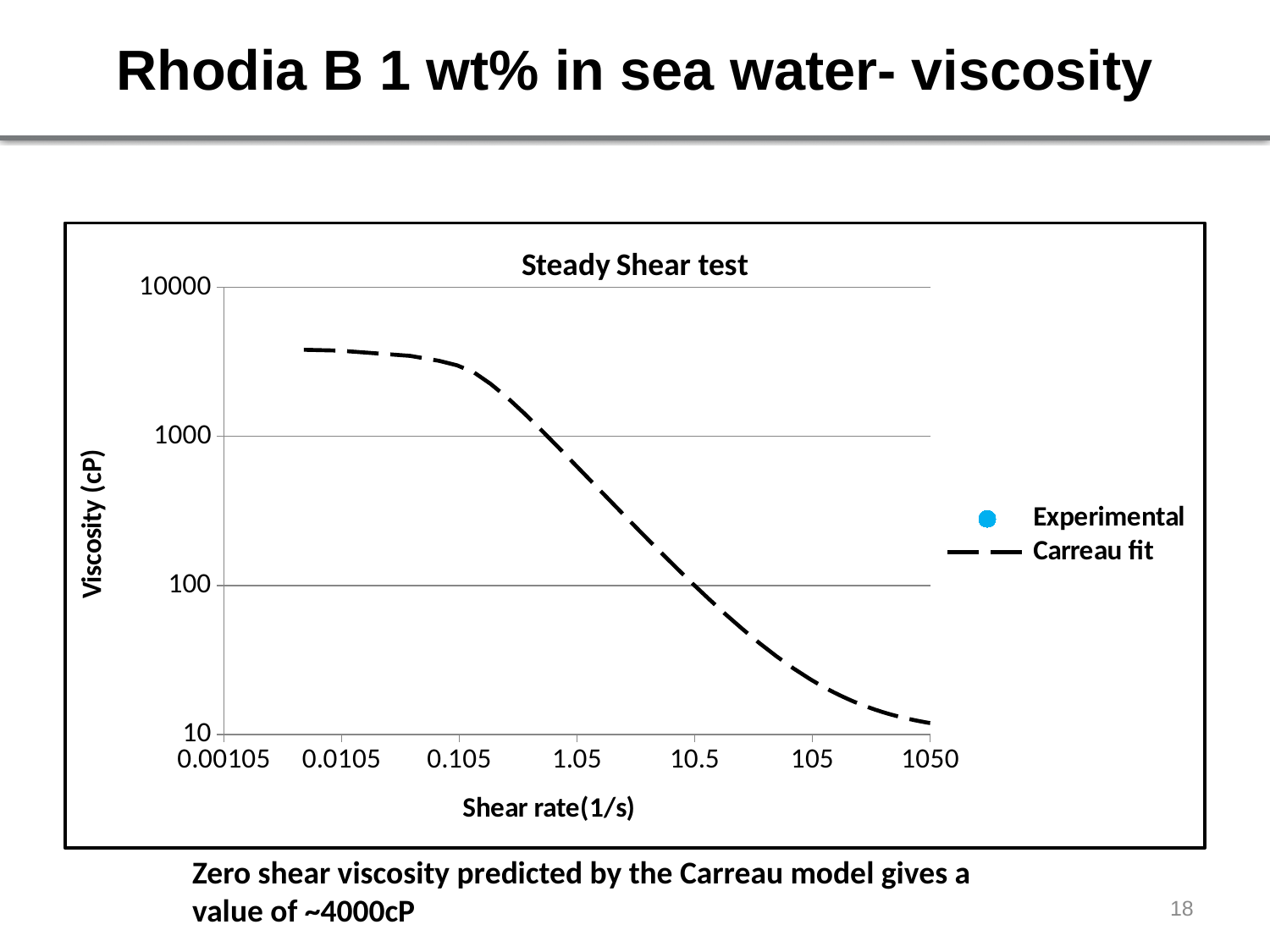
How many series does the chart legend list? 2 Is the Carreau fit viscosity at a shear rate of 0.0105 1/s greater or less than 1000 cP? greater Does the Carreau fit viscosity rise or fall as shear rate increases along the x axis? fall What is the label of the y axis? Viscosity (cP) What are the two series named in the legend? Experimental and Carreau fit What is the label of the x axis? Shear rate(1/s) Is the Carreau fit viscosity at a shear rate of 1.05 1/s greater or less than 1000 cP? less What kind of chart is shown on the slide? line chart What is the title of the chart? Steady Shear test Which shear rate has the higher Carreau fit viscosity, 0.105 1/s or 10.5 1/s? 0.105 1/s Is the Carreau fit viscosity at a shear rate of 105 1/s greater or less than 100 cP? less